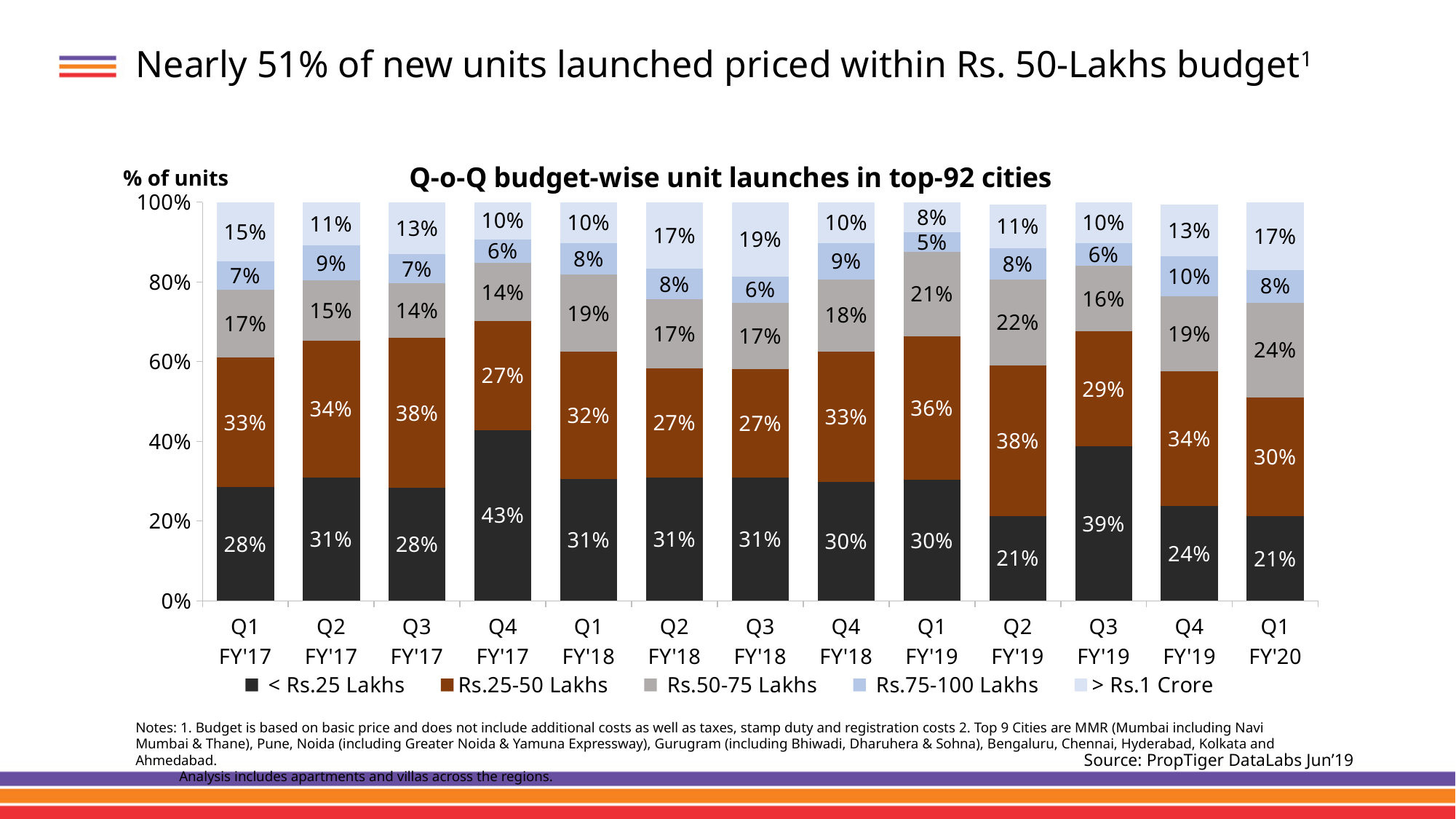
How many budget categories does the legend list? 5 What is the combined share of units priced below Rs.50 Lakhs (< Rs.25 Lakhs plus Rs.25-50 Lakhs) in Q1 FY'20? 51% In which quarter was the share of units in the Rs.75-100 Lakhs budget the lowest? Q1 FY'19 What percentage of units launched in Q3 FY'18 were priced above Rs.1 Crore? 19% What type of chart is used to show the Q-o-Q budget-wise unit launches? Stacked bar chart How many quarters are shown on the x axis of the chart? 13 Which is larger in Q2 FY'19: the share of units priced below Rs.25 Lakhs or the share in the Rs.25-50 Lakhs budget? Rs.25-50 Lakhs In which quarter was the share of units priced below Rs.25 Lakhs the highest? Q4 FY'17 In which quarter was the share of units priced above Rs.1 Crore the lowest? Q1 FY'19 What percentage of units launched in Q4 FY'17 were priced below Rs.25 Lakhs? 43% How much higher is the share of units priced below Rs.25 Lakhs in Q4 FY'17 than in Q1 FY'20? 22 percentage points What is the share of units in the Rs.50-75 Lakhs budget in Q1 FY'20? 24%